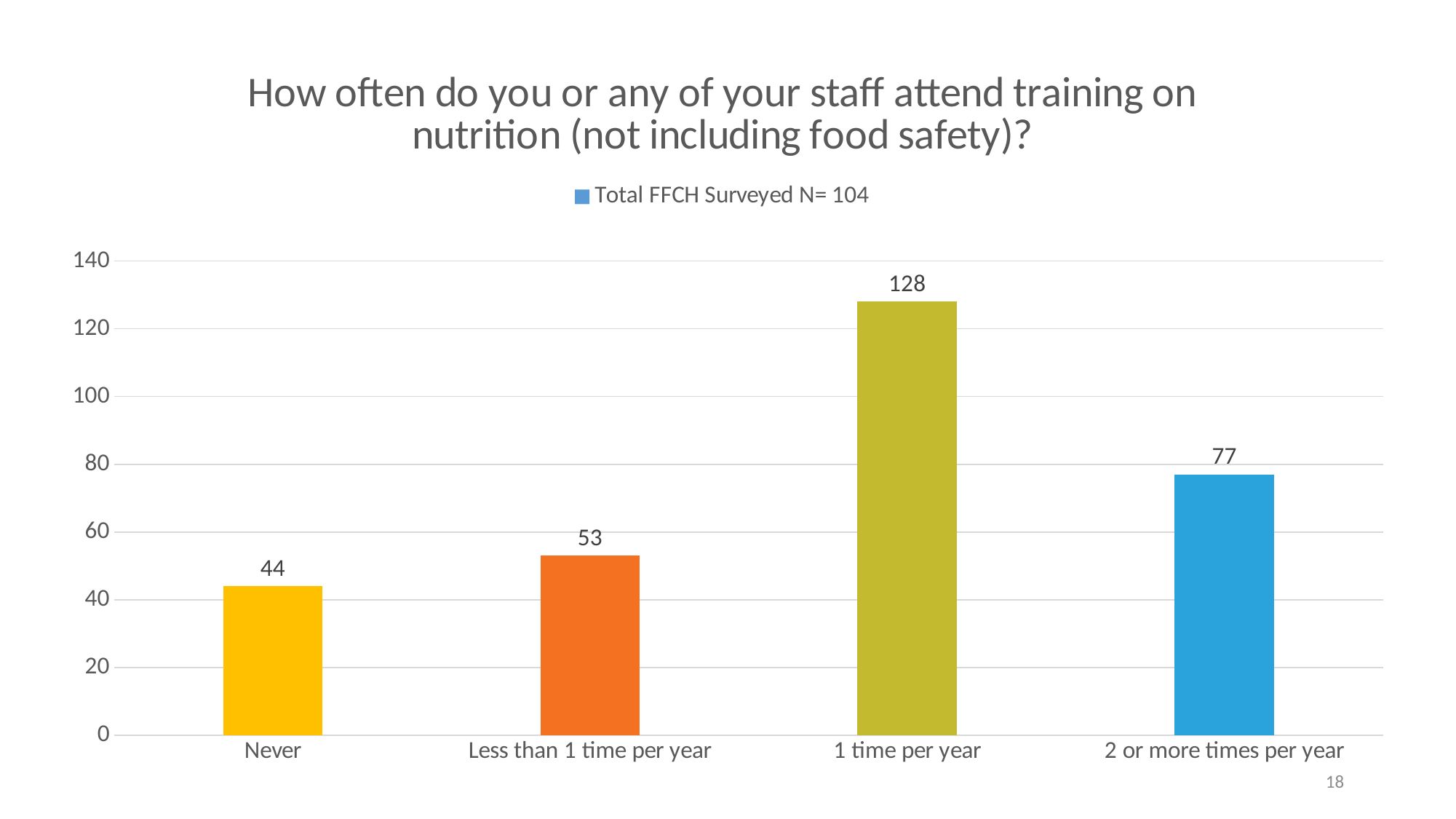
Which category has the highest value? 1 time per year What is the value for "Less than 1 time per year"? 53 What is the difference between the values for "1 time per year" and "2 or more times per year"? 51 Which is larger, the value for "Less than 1 time per year" or the value for "Never"? Less than 1 time per year What is the value for "Never"? 44 What is the value for "1 time per year"? 128 What kind of chart is shown on the slide? bar chart What is the value for "2 or more times per year"? 77 Which category has the lowest value? Never What is the legend entry shown on the chart? Total FFCH Surveyed N= 104 Is the value for "2 or more times per year" greater or less than 80? less How many categories are shown on the x axis? 4